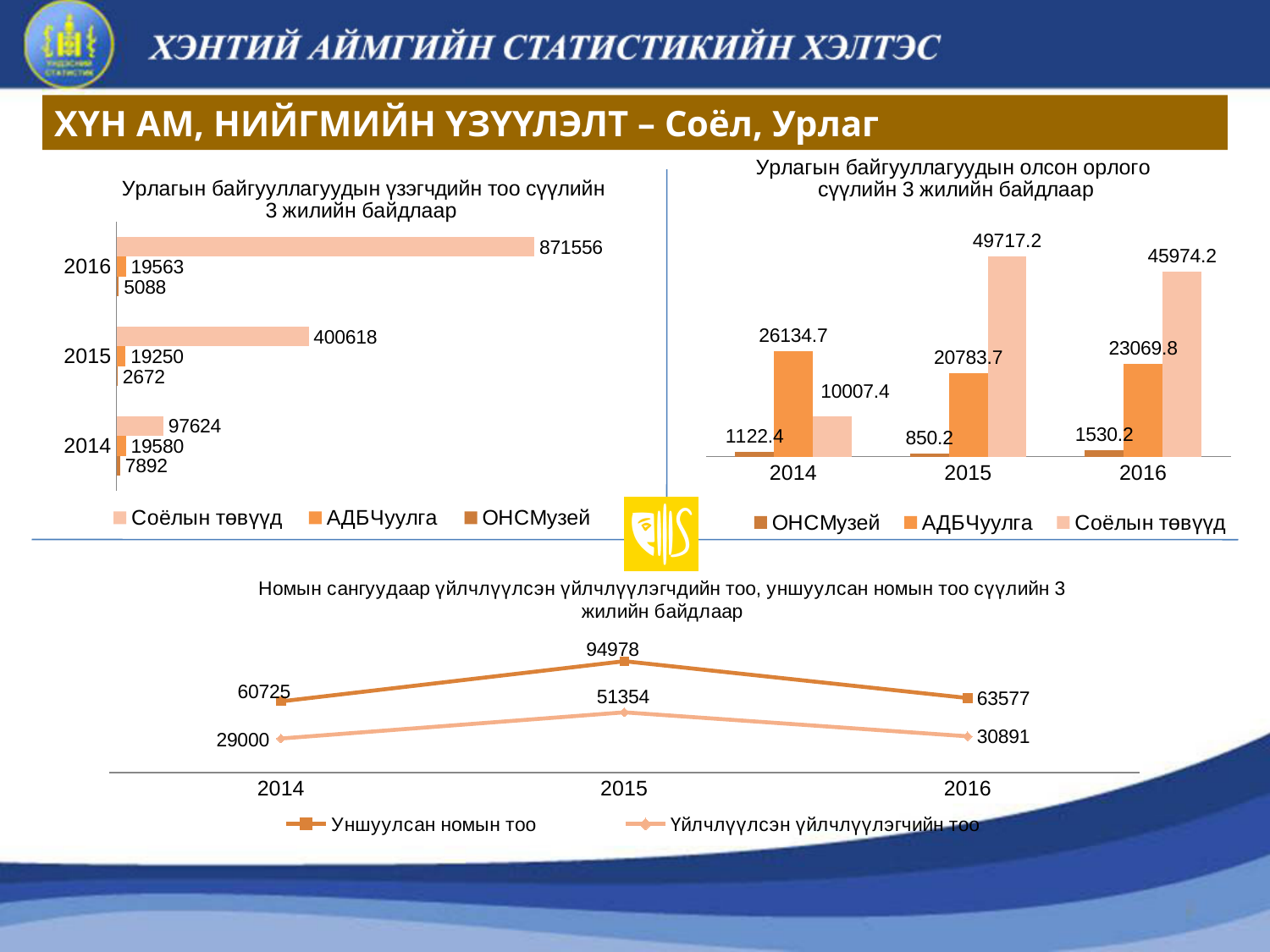
In the top-right chart (Урлагын байгууллагуудын олсон орлого), what is the value for Соёлын төвүүд in 2015? 49717.2 In the top-right chart (Урлагын байгууллагуудын олсон орлого), how many series does the legend list? 3 In the top-left chart (Урлагын байгууллагуудын үзэгчдийн тоо), what kind of chart is it? Bar chart In the bottom chart (Номын сангуудаар үйлчлүүлсэн...), how many years are shown on the x axis? 3 In the top-right chart (Урлагын байгууллагуудын олсон орлого), which is larger in 2014: АДБЧуулга or Соёлын төвүүд? АДБЧуулга In the bottom chart (Номын сангуудаар үйлчлүүлсэн...), what is the difference between Уншуулсан номын тоо and Үйлчлүүлсэн үйлчлүүлэгчийн тоо in 2016? 32686 In the top-left chart (Урлагын байгууллагуудын үзэгчдийн тоо), what is the value for ОНСМузей in 2015? 2672 In the top-right chart (Урлагын байгууллагуудын олсон орлого), which year has the lowest value for ОНСМузей? 2015 In the bottom chart (Номын сангуудаар үйлчлүүлсэн...), which year has the highest value for Үйлчлүүлсэн үйлчлүүлэгчийн тоо? 2015 In the top-left chart (Урлагын байгууллагуудын үзэгчдийн тоо), what is the value for Соёлын төвүүд in 2016? 871556 In the top-left chart (Урлагын байгууллагуудын үзэгчдийн тоо), what is the difference between the Соёлын төвүүд values for 2016 and 2015? 470938 In the bottom chart (Номын сангуудаар үйлчлүүлсэн...), what is the value for Уншуулсан номын тоо in 2015? 94978